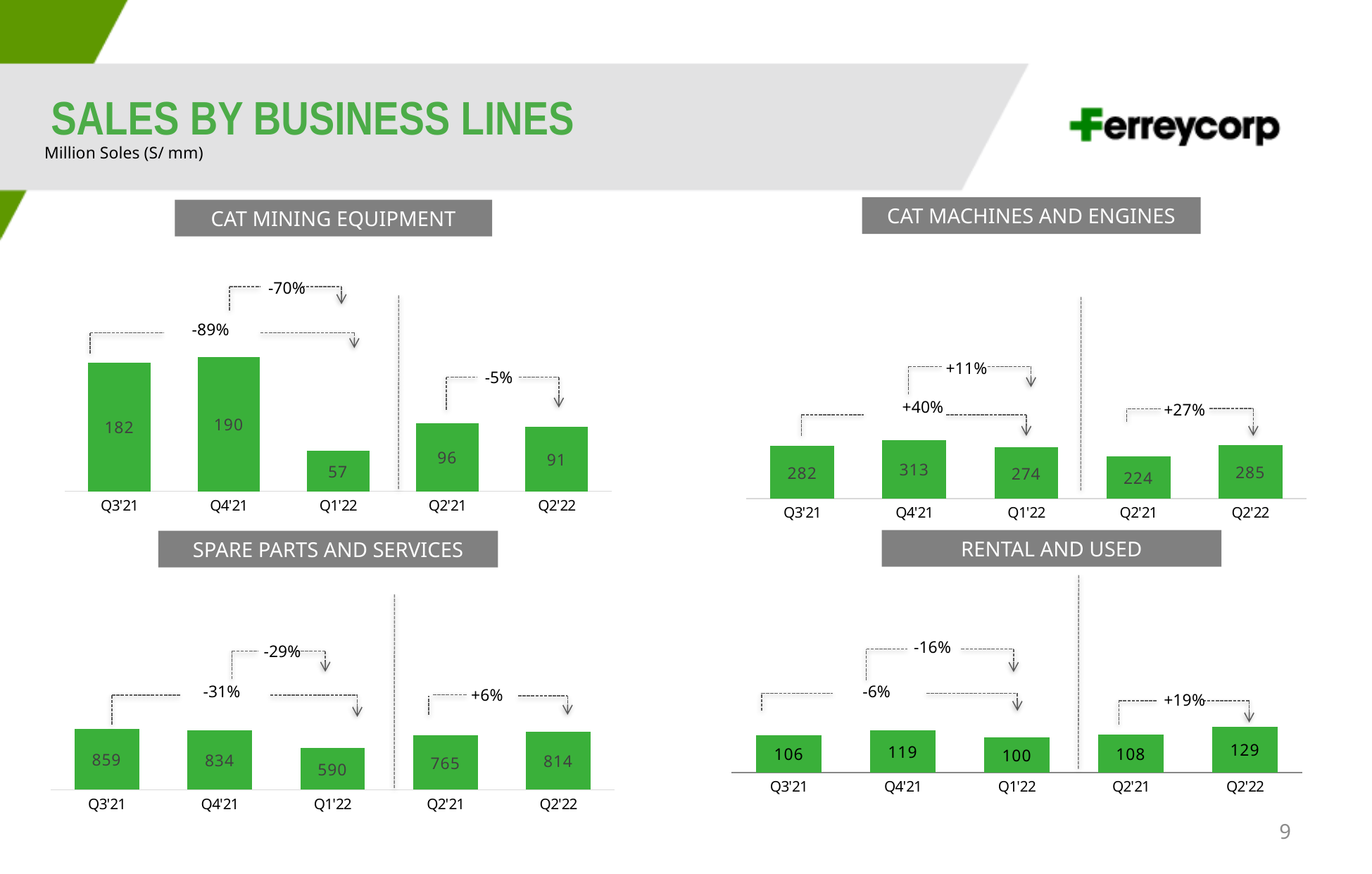
In the CAT MACHINES AND ENGINES chart, what is the value for Q1'22? 274 In the RENTAL AND USED chart, which quarter has the lowest value? Q1'22 What type of chart is the CAT MINING EQUIPMENT chart? Bar chart In the CAT MINING EQUIPMENT chart, what is the value for Q1'22? 57 In the CAT MACHINES AND ENGINES chart, which quarter has the highest value? Q4'21 In the RENTAL AND USED chart, what percentage change is shown between Q2'21 and Q2'22? +19% In the CAT MACHINES AND ENGINES chart, which is larger, the value for Q2'21 or Q2'22? Q2'22 In the CAT MINING EQUIPMENT chart, what is the difference between the Q4'21 and Q3'21 values? 8 In the SPARE PARTS AND SERVICES chart, do the values rise or fall from Q3'21 to Q1'22? Fall How many bars are shown in the RENTAL AND USED chart? 5 In the SPARE PARTS AND SERVICES chart, what is the value for Q2'22? 814 In the SPARE PARTS AND SERVICES chart, what is the difference between the Q2'22 and Q2'21 values? 49